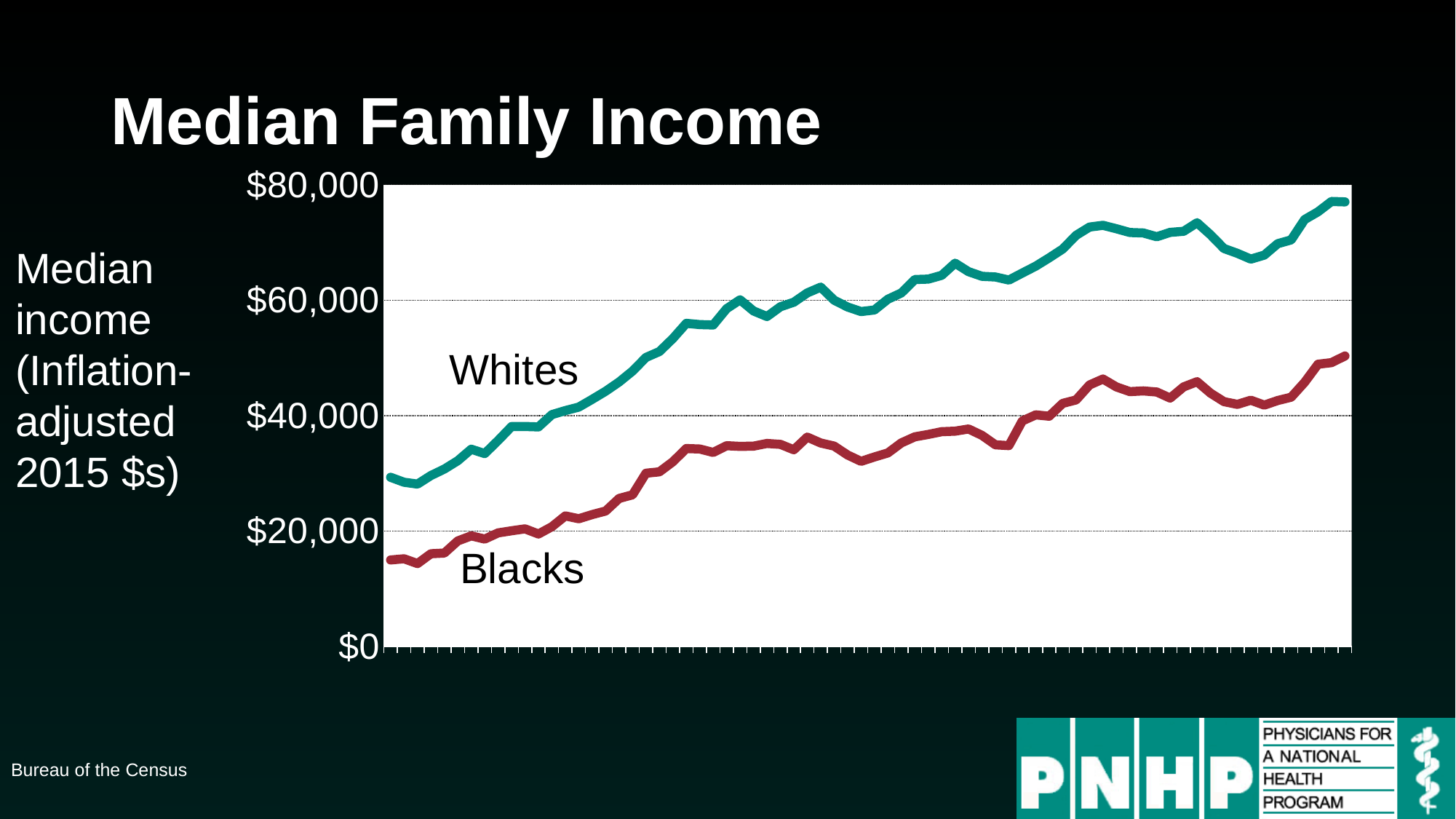
Is the value for Blacks at the left end of the chart greater or less than $20,000? less Is the value for Blacks at the right end of the chart greater or less than $40,000? greater How many series (lines) are plotted on the chart? 2 Which series has the higher median income at the right end of the chart, Whites or Blacks? Whites Is the value for Whites at the right end of the chart greater or less than $60,000? greater Which series is plotted with the teal line? Whites What is the title of the chart? Median Family Income Overall, does the Blacks line rise or fall from left to right? rise Overall, does the Whites line rise or fall from left to right? rise What kind of chart is shown on the slide? line chart